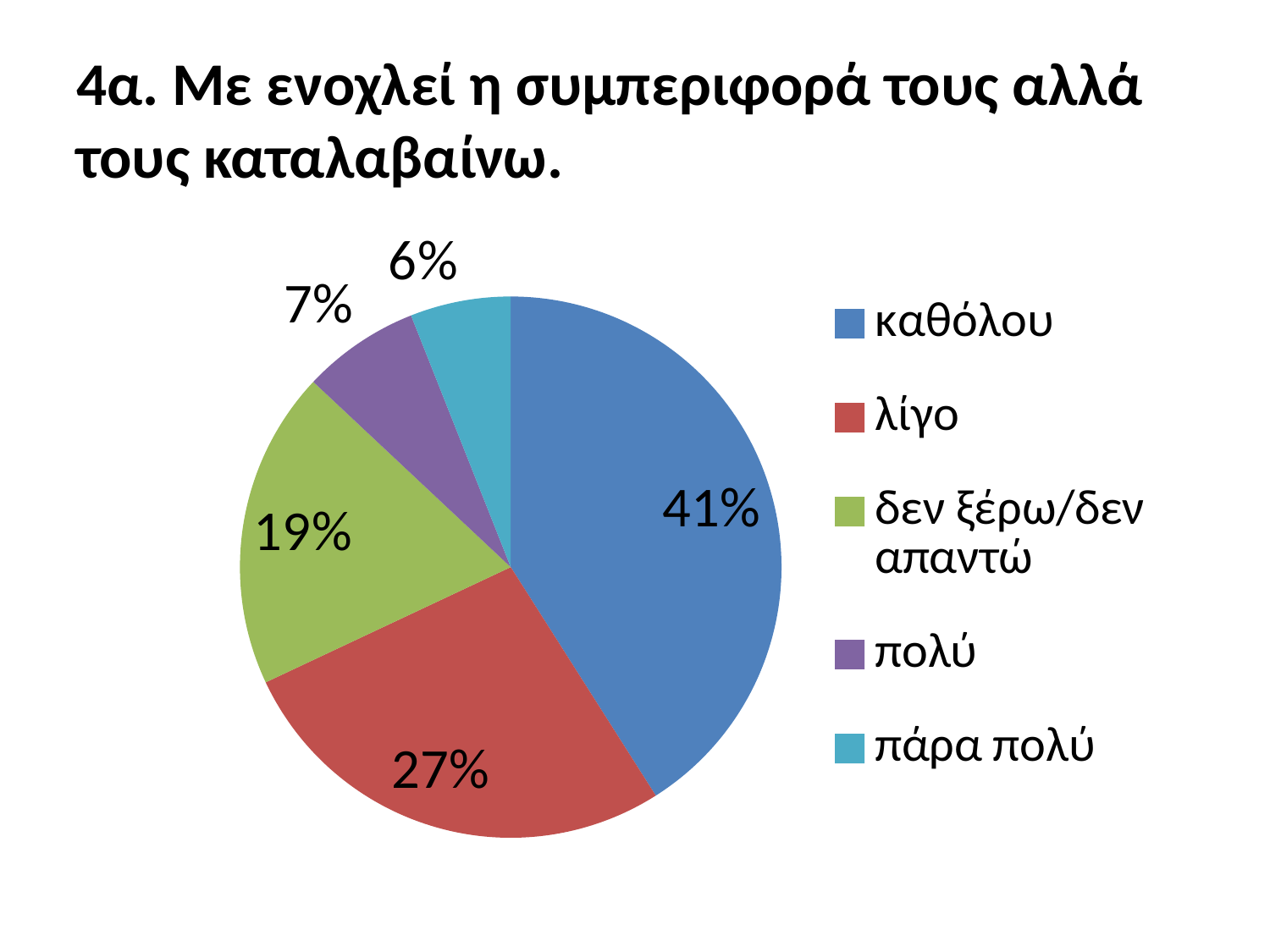
What percentage of the pie is the δεν ξέρω/δεν απαντώ slice? 19% What percentage of the pie is the καθόλου slice? 41% What is the difference in percentage points between the καθόλου and λίγο slices? 14 What percentage of the pie is the λίγο slice? 27% Which slice is larger, λίγο or δεν ξέρω/δεν απαντώ? λίγο What colour is the λίγο slice in the pie chart? red Which category has the largest slice of the pie? καθόλου How many slices does the pie chart have? 5 Which category has the smallest slice of the pie? πάρα πολύ What kind of chart is shown on the slide? pie chart